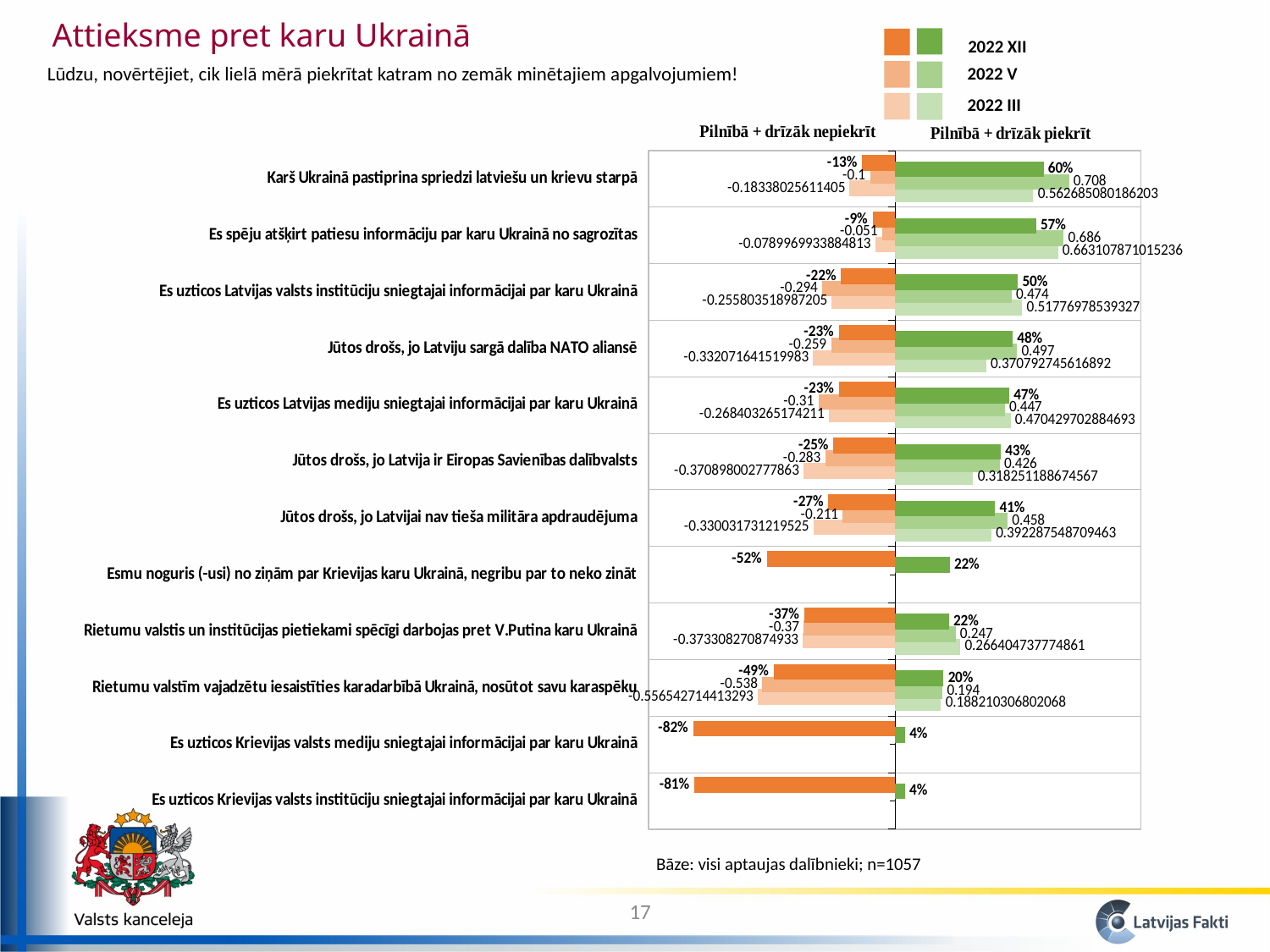
Which statement has the largest 2022 XII 'Pilnībā + drīzāk nepiekrīt' share? Es uzticos Krievijas valsts mediju sniegtajai informācijai par karu Ukrainā In 2022 XII, which statement has a higher agreement share: 'Jūtos drošs, jo Latviju sargā dalība NATO aliansē' or 'Jūtos drošs, jo Latvija ir Eiropas Savienības dalībvalsts'? Jūtos drošs, jo Latviju sargā dalība NATO aliansē How many statements (categories) are plotted in the chart? 12 What is the 2022 XII 'Pilnībā + drīzāk piekrīt' value for 'Karš Ukrainā pastiprina spriedzi latviešu un krievu starpā'? 60% Which statement has the highest 2022 XII 'Pilnībā + drīzāk piekrīt' share? Karš Ukrainā pastiprina spriedzi latviešu un krievu starpā What is the 2022 XII 'Pilnībā + drīzāk nepiekrīt' value for 'Esmu noguris (-usi) no ziņām par Krievijas karu Ukrainā, negribu par to neko zināt'? -52% What kind of chart is shown on the slide? bar chart What is the 2022 XII 'Pilnībā + drīzāk piekrīt' value for 'Rietumu valstīm vajadzētu iesaistīties karadarbībā Ukrainā, nosūtot savu karaspēku'? 20% What is the title of the slide's chart? Attieksme pret karu Ukrainā What is the 2022 V 'Pilnībā + drīzāk piekrīt' value for 'Es spēju atšķirt patiesu informāciju par karu Ukrainā no sagrozītas'? 0.686 How many survey waves does the legend list? 3 What is the difference in 2022 XII agreement between 'Karš Ukrainā pastiprina spriedzi latviešu un krievu starpā' and 'Es spēju atšķirt patiesu informāciju par karu Ukrainā no sagrozītas'? 3 percentage points